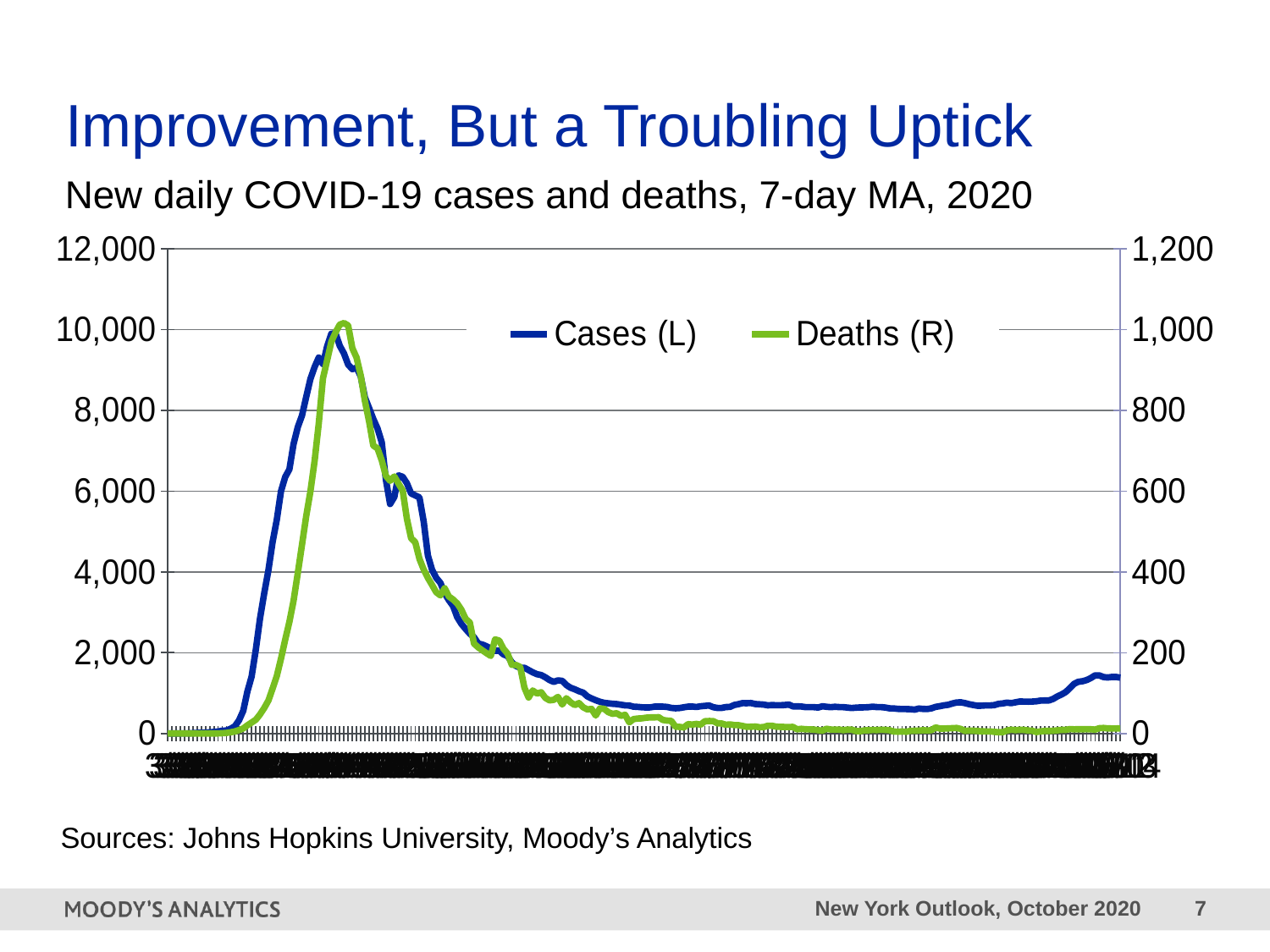
Is the peak value of the Cases (L) line greater or less than 8,000? greater After reaching its peak, does the Deaths (R) line rise or fall along the x axis? fall Is the peak value of the Deaths (R) line greater or less than 600? greater How many series does the legend list? 2 What are the two series listed in the chart legend? Cases (L) and Deaths (R) After reaching its peak, does the Cases (L) line mainly rise or fall along the x axis? fall What kind of chart is shown on the slide? line chart What is the title of the chart? New daily COVID-19 cases and deaths, 7-day MA, 2020 Is the peak value of the Cases (L) line greater or less than 12,000? less Near the far right end of the chart, does the Cases (L) line rise or fall? rise